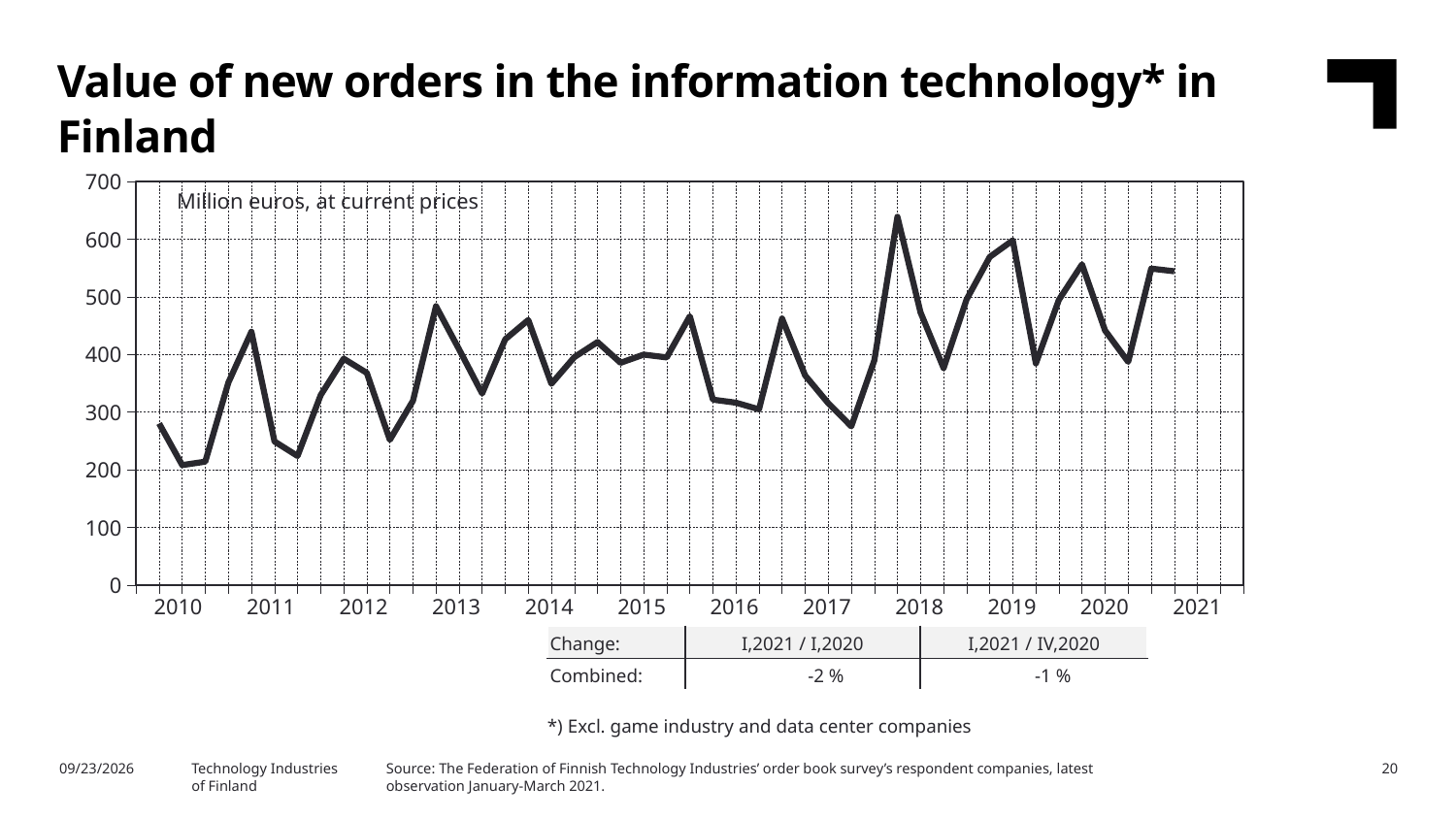
How many years are labeled on the x axis? 12 What is the combined change for I,2021 / I,2020 shown in the table below the chart? -2 % What is the combined change for I,2021 / IV,2020 shown in the table below the chart? -1 % What kind of chart is shown on the slide? line chart Is the lowest point of the line, in 2010, greater or less than 300? less In what unit are the values on the chart expressed? Million euros, at current prices Is the value at the first point of the line (start of 2010) greater or less than 300? less Is the highest point of the line, reached around the start of 2018, greater or less than 600? greater What is the maximum value shown on the y axis? 700 What is the title of the chart? Value of new orders in the information technology* in Finland